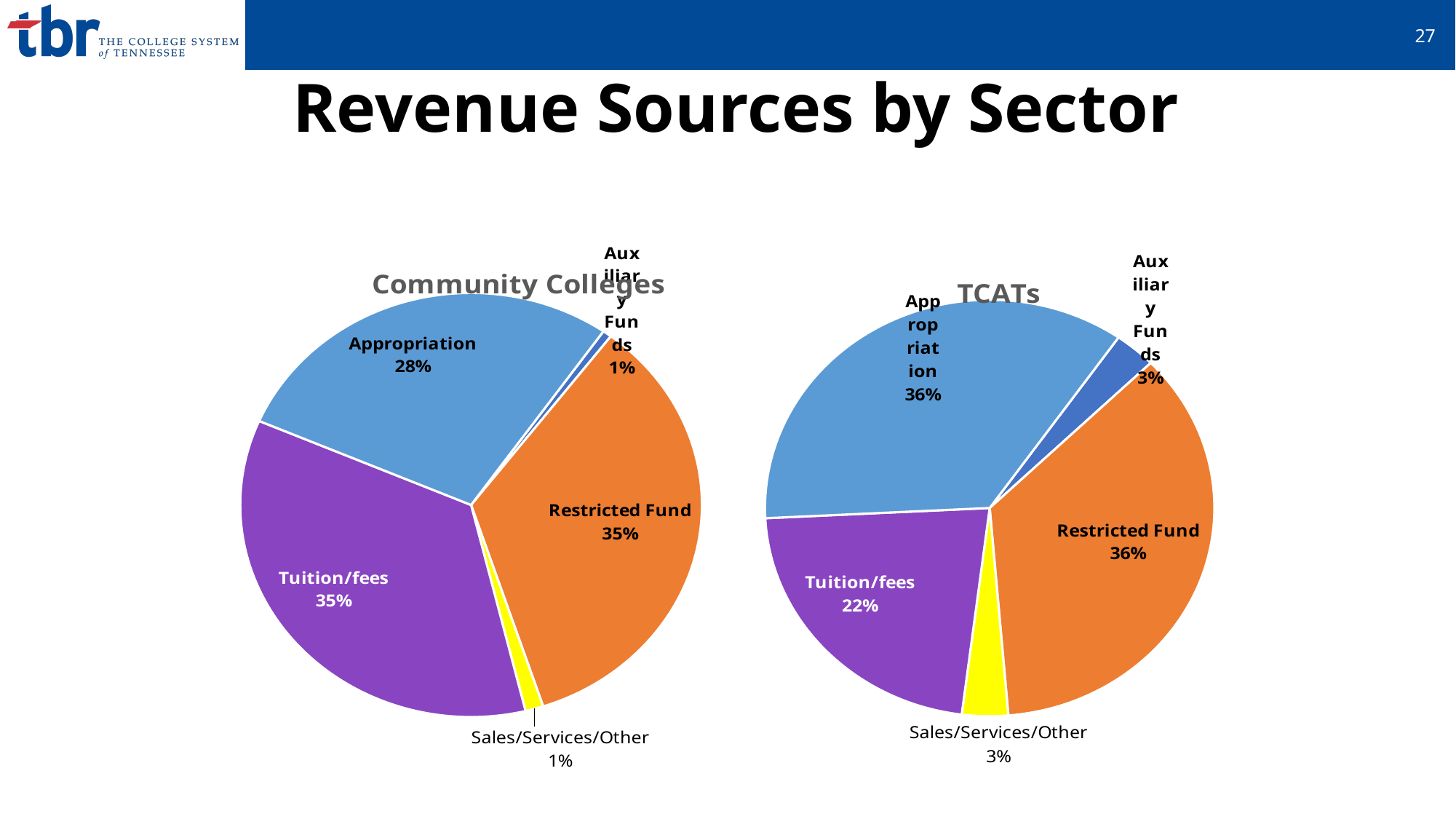
In the TCATs pie chart, what share of revenue comes from Tuition/fees? 22% In the Community Colleges pie chart, what share of revenue comes from Tuition/fees? 35% In the Community Colleges pie chart, what share of revenue comes from Appropriation? 28% What is the title of the chart on the right side of the slide? TCATs In the TCATs pie chart, what is the difference between the Appropriation share and the Tuition/fees share? 14% In the Community Colleges pie chart, which is larger: Restricted Fund or Auxiliary Funds? Restricted Fund In the Community Colleges pie chart, what is the difference between the Tuition/fees share and the Appropriation share? 7% In the TCATs pie chart, what share of revenue comes from Restricted Fund? 36% How many slices does the TCATs pie chart have? 5 In the TCATs pie chart, which is larger: Appropriation or Tuition/fees? Appropriation What kind of chart is the Community Colleges chart? Pie chart In the TCATs pie chart, what share of revenue comes from Auxiliary Funds? 3%